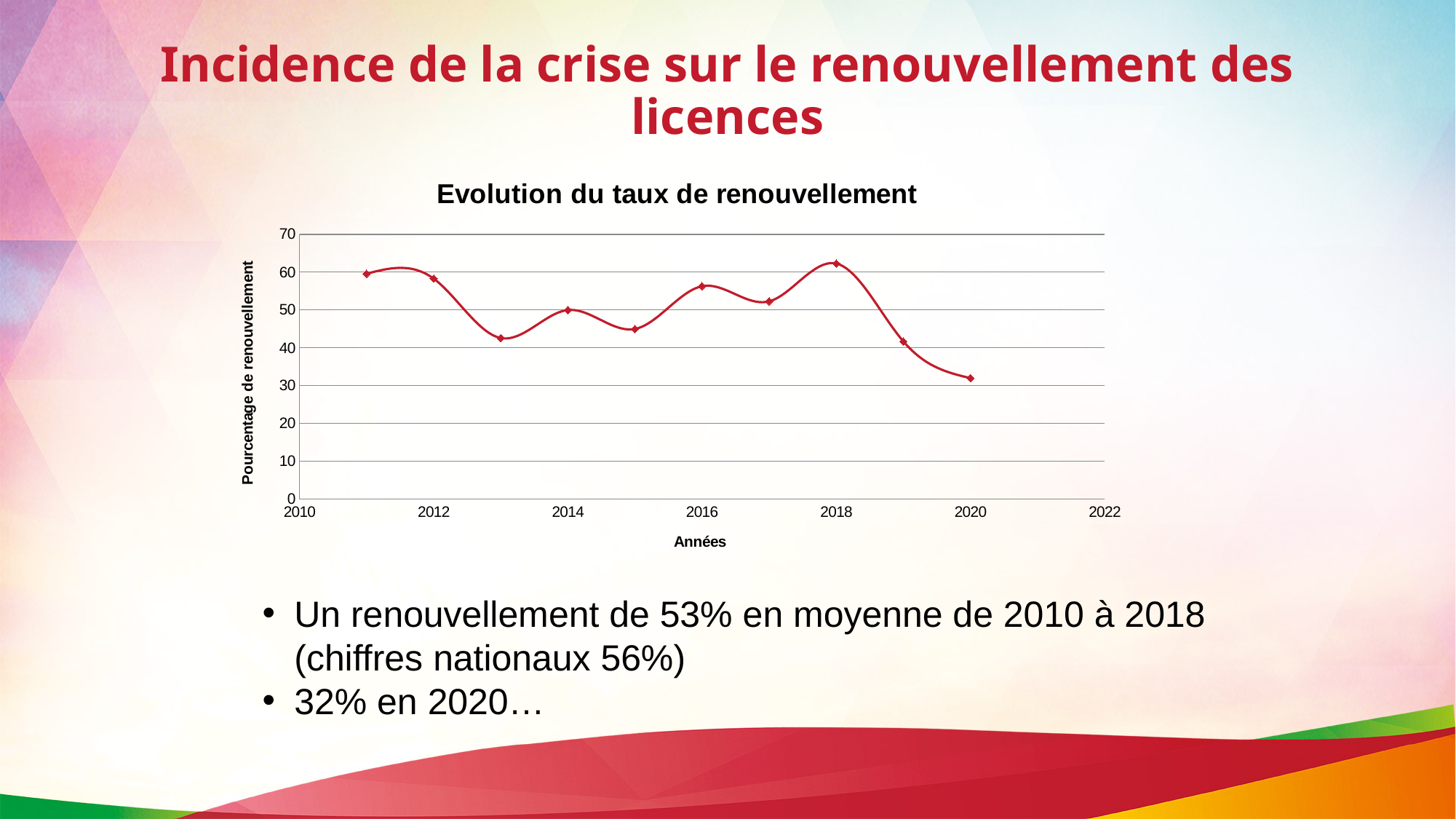
Is the value for 2013 greater or less than 50? less In which year is the renewal rate highest? 2018 What is the label of the vertical axis of the chart? Pourcentage de renouvellement Is the value for 2011 greater or less than 50? greater What kind of chart is shown on the slide? line chart Does the renewal rate rise or fall between 2018 and 2020? fall Which year has the higher renewal rate, 2013 or 2014? 2014 What is the title of the chart? Evolution du taux de renouvellement What is the renewal rate in 2020, as stated on the slide? 32% Is the value for 2019 greater or less than 50? less How many data points are plotted on the line? 10 In which year is the renewal rate lowest? 2020